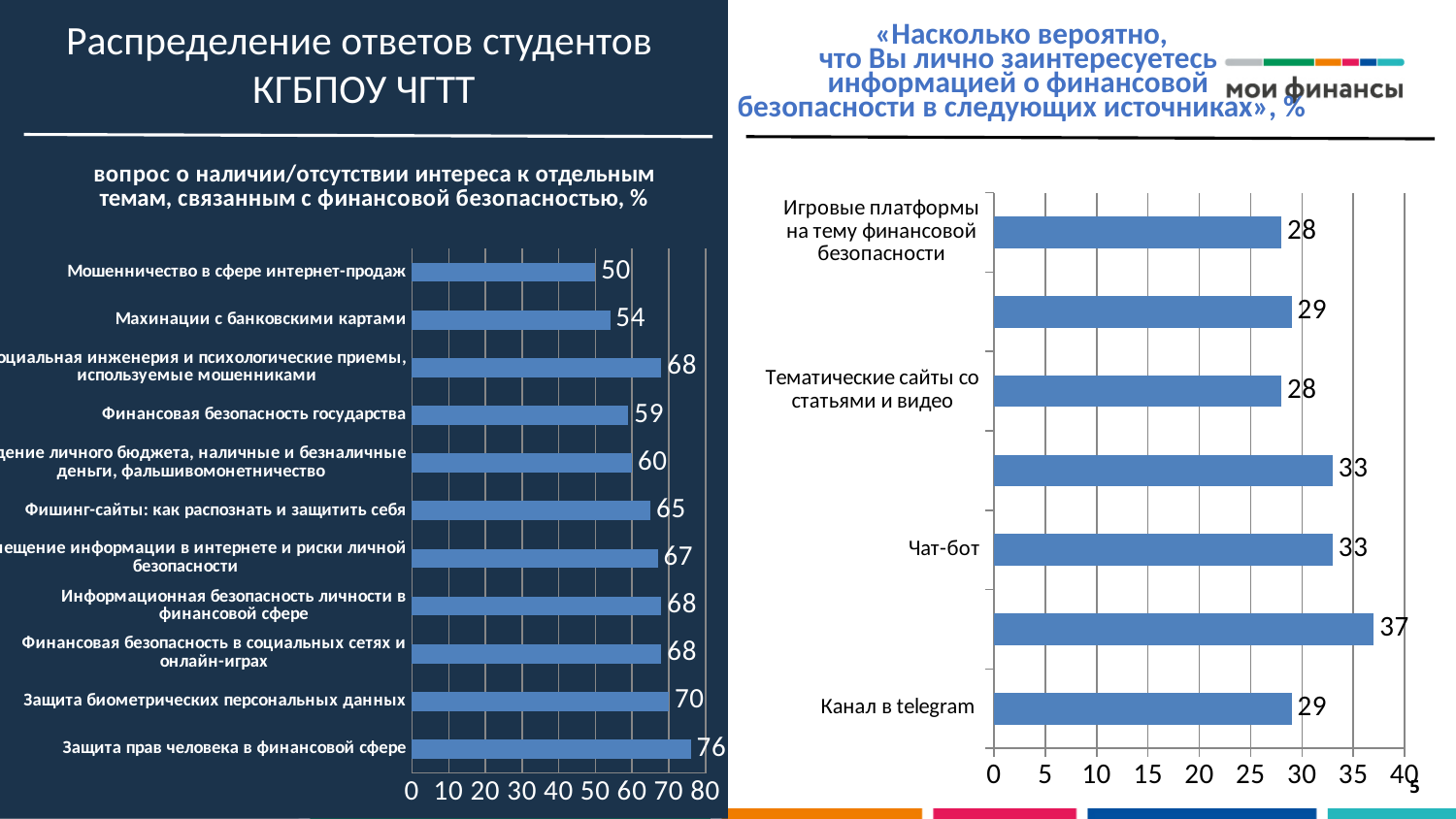
On the left chart about interest in financial security topics, which category has the lowest value? Мошенничество в сфере интернет-продаж On the right chart about sources of financial security information, which is larger: «Чат-бот» or «Игровые платформы на тему финансовой безопасности»? Чат-бот On the left chart about interest in financial security topics, which category has the highest value? Защита прав человека в финансовой сфере On the left chart about interest in financial security topics, what is the difference between «Защита прав человека в финансовой сфере» and «Махинации с банковскими картами»? 22 On the right chart about sources of financial security information, what is the value for «Канал в telegram»? 29 What type of chart is used on the right side of the slide? Bar chart On the left chart about interest in financial security topics, what is the value for «Защита прав человека в финансовой сфере»? 76 On the left chart about interest in financial security topics, what is the value for «Мошенничество в сфере интернет-продаж»? 50 On the right chart about sources of financial security information, what is the value for «Чат-бот»? 33 On the left chart about interest in financial security topics, what is the value for «Защита биометрических персональных данных»? 70 On the right chart about sources of financial security information, what is the highest value shown? 37 On the left chart about interest in financial security topics, how many categories are plotted? 11